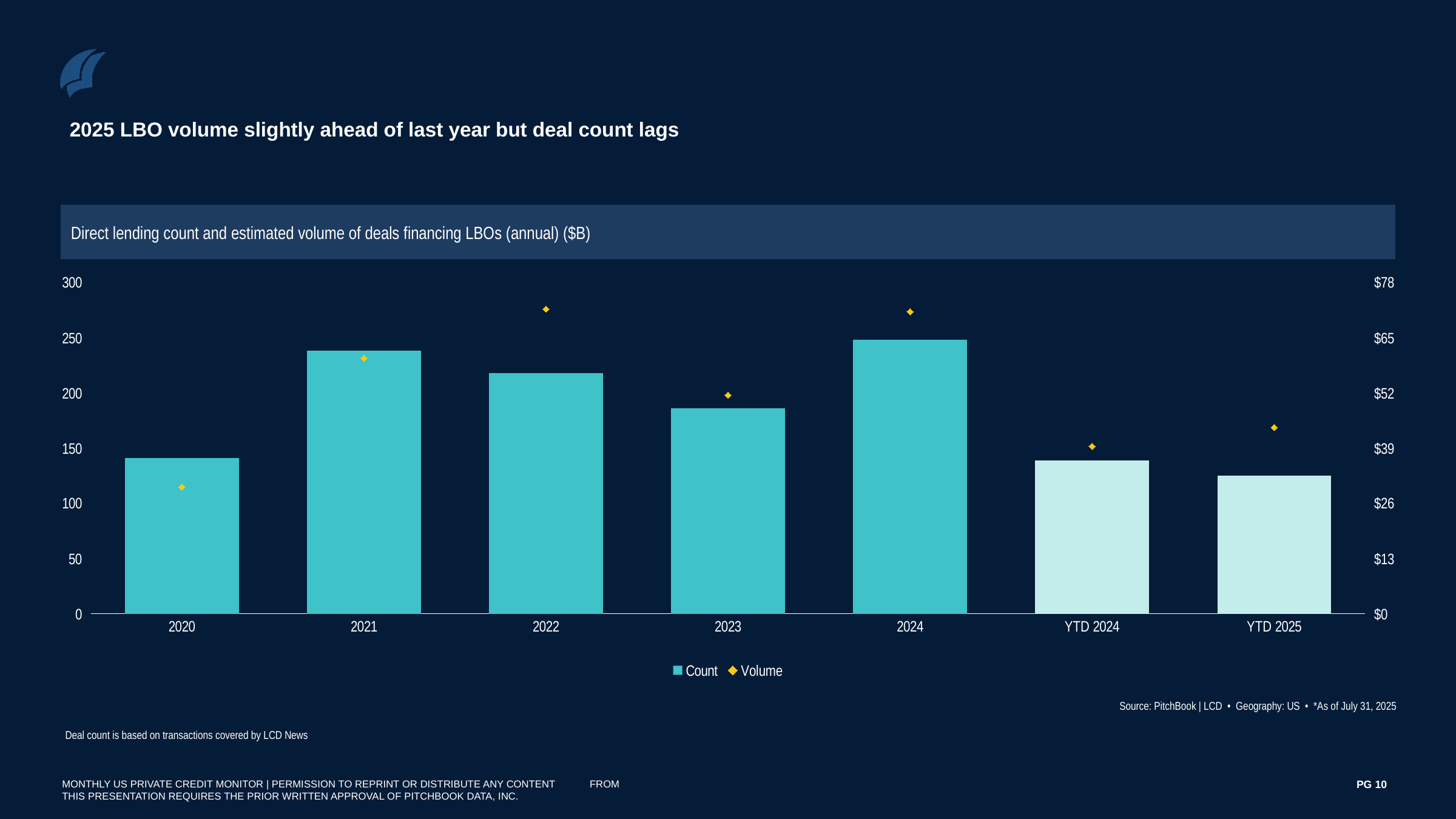
Is the Count value for 2023 greater or less than 200? less Which has the larger Count, 2021 or 2022? 2021 Which category has the lowest Volume marker? 2020 Is the Count value for 2020 greater or less than 150? less How many series does the legend list? 2 Which category has the lowest Count bar? YTD 2025 Which has the larger Count, YTD 2024 or YTD 2025? YTD 2024 What kind of chart is shown on the slide? combination bar and line chart (bars for Count, diamond markers for Volume) Does the Count rise or fall from 2021 to 2023? fall Is the Volume value for 2022 greater or less than $65? greater How many categories are shown on the x axis? 7 Which year has the highest Count bar? 2024